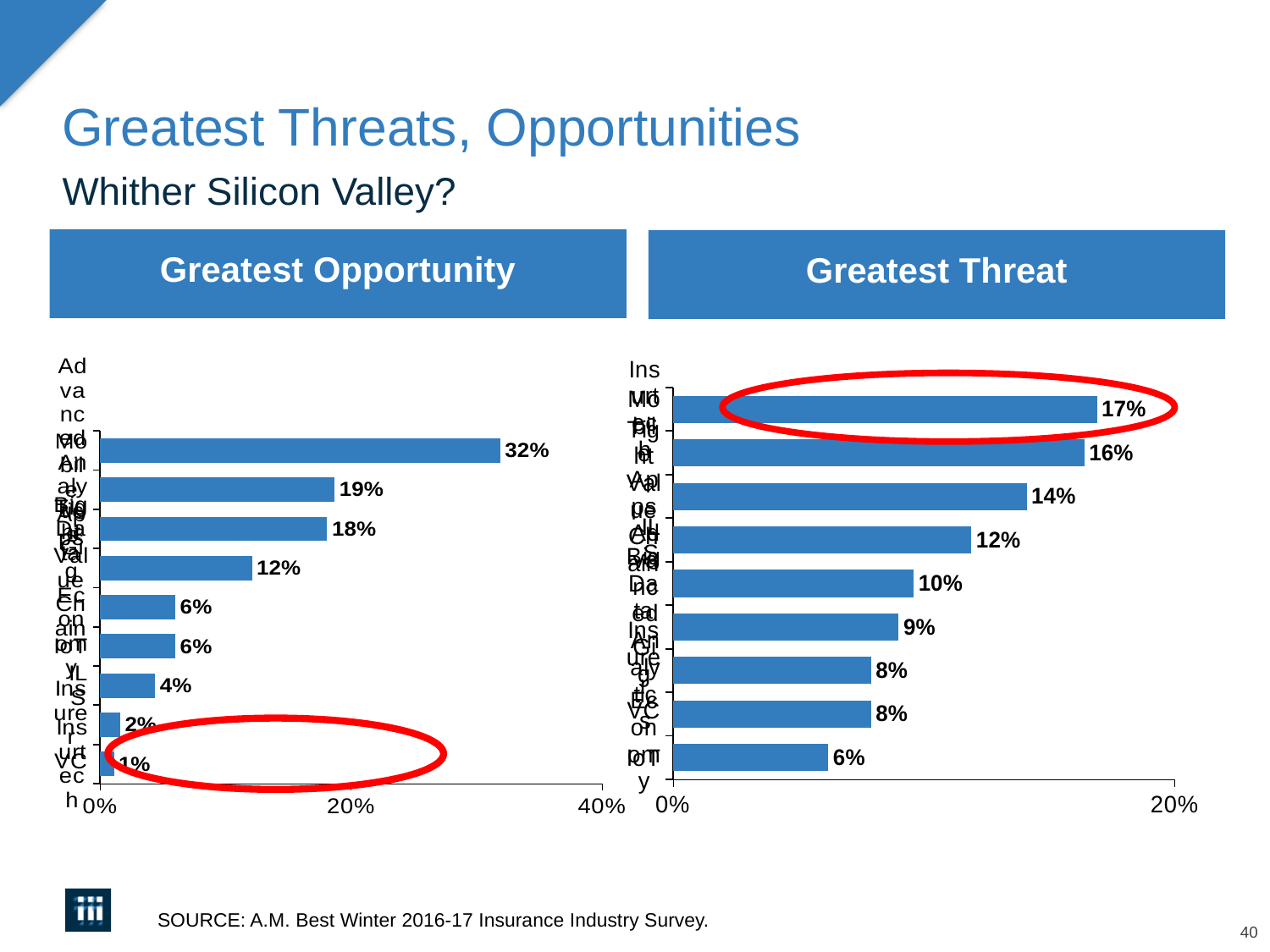
In the Greatest Opportunity chart, what is the value of the longest bar? 32% How many bars are plotted in the Greatest Opportunity chart? 9 What is the maximum value shown on the x axis of the Greatest Threat chart? 20% In the Greatest Threat chart, what is the difference between the top bar and the second bar? 1% In the Greatest Opportunity chart, what is the difference between the largest value and the smallest value? 31% What type of chart is the Greatest Opportunity chart? bar chart In the Greatest Opportunity chart, what is the value of the second bar from the top? 19% How many bars are plotted in the Greatest Threat chart? 9 In the Greatest Opportunity chart, what is the value of the shortest bar? 1% In the Greatest Threat chart, what is the value of the longest bar? 17% In the Greatest Threat chart, what is the value of the shortest bar? 6% Which is larger: the longest bar in the Greatest Opportunity chart or the longest bar in the Greatest Threat chart? Greatest Opportunity